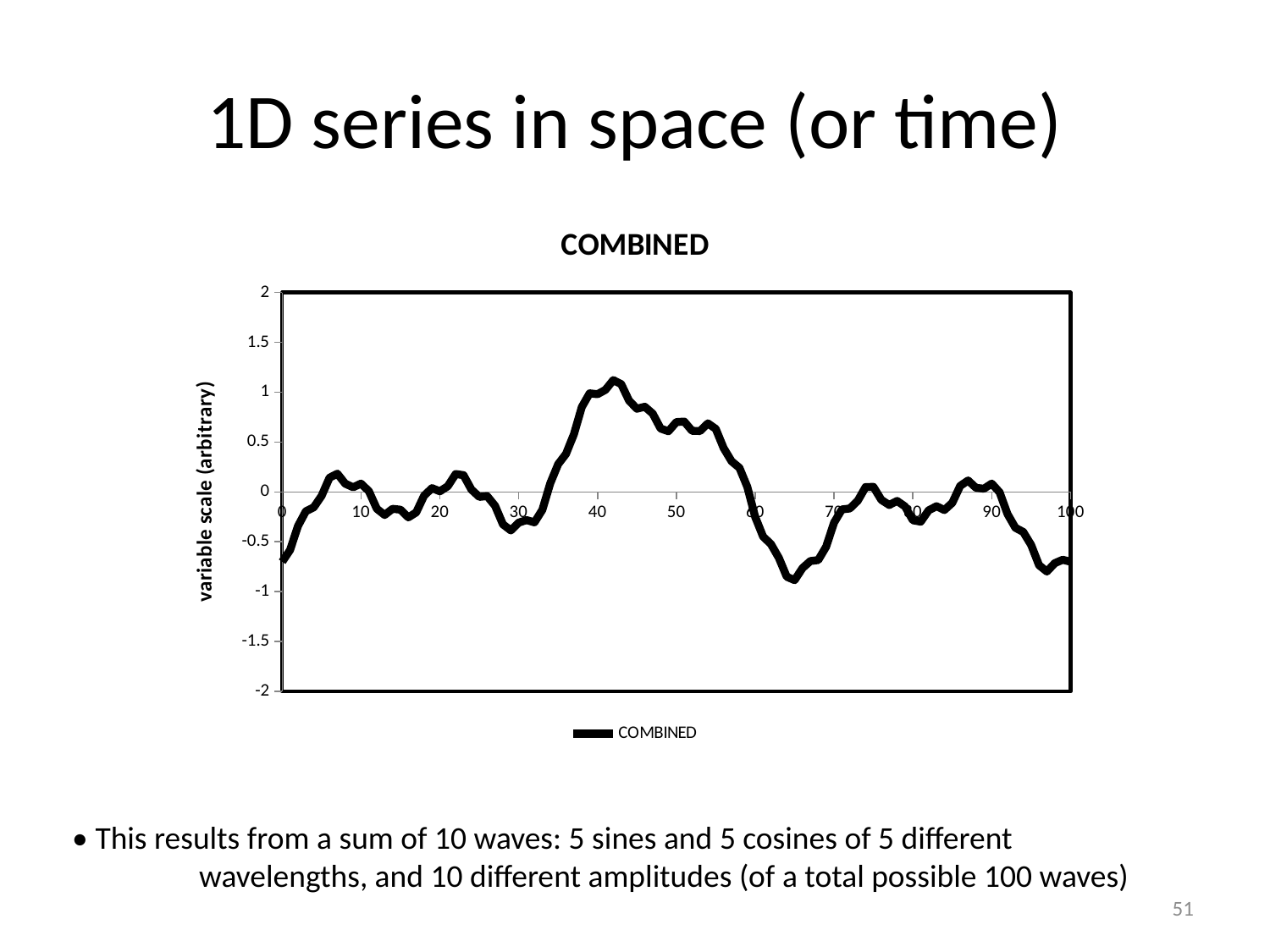
Does the COMBINED series rise or fall between x = 55 and x = 65? fall How many series does the legend list? 1 Is the value of the COMBINED series at x = 95 greater or less than 0? less What is the label on the vertical axis of the chart? variable scale (arbitrary) Is the value of the COMBINED series at x = 65 greater or less than -0.5? less Is the value of the COMBINED series at x = 0 greater or less than -0.5? less What is the title of the chart? COMBINED Does the COMBINED series rise or fall between x = 30 and x = 40? rise What kind of chart is shown on the slide? line chart